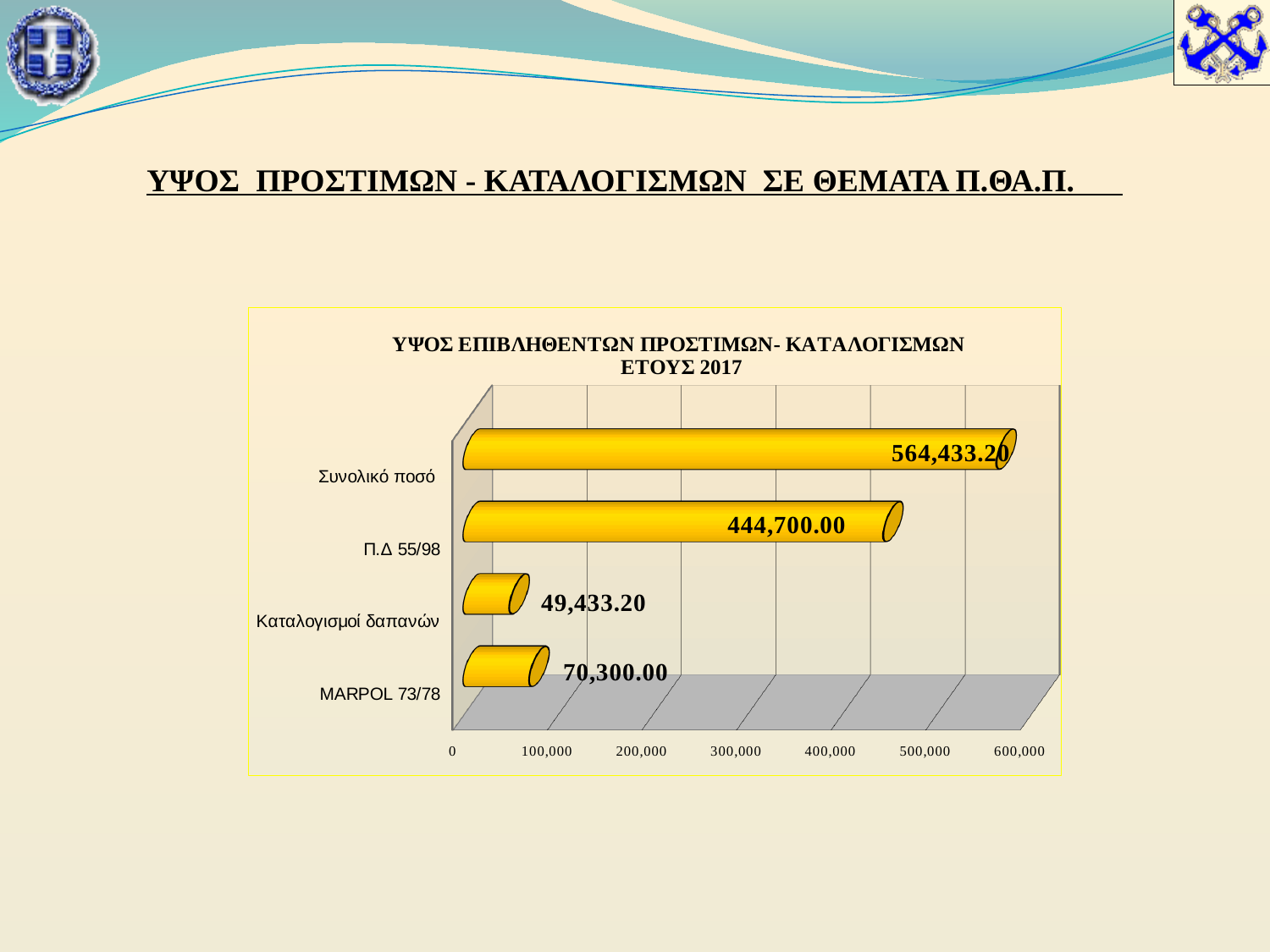
Which category has the lowest value? Καταλογισμοί δαπανών What is the value for Καταλογισμοί δαπανών? 49,433.20 Which is larger, the value for MARPOL 73/78 or the value for Καταλογισμοί δαπανών? MARPOL 73/78 What is the difference between the values for MARPOL 73/78 and Καταλογισμοί δαπανών? 20,866.80 How many categories are shown in the chart? 4 What is the value for MARPOL 73/78? 70,300.00 What kind of chart is shown on the slide? Bar chart What is the difference between the values for Συνολικό ποσό and Π.Δ 55/98? 119,733.20 Which category has the highest value? Συνολικό ποσό What is the value for Π.Δ 55/98? 444,700.00 What is the value for Συνολικό ποσό? 564,433.20 Is the value for Π.Δ 55/98 greater or less than 400,000? greater